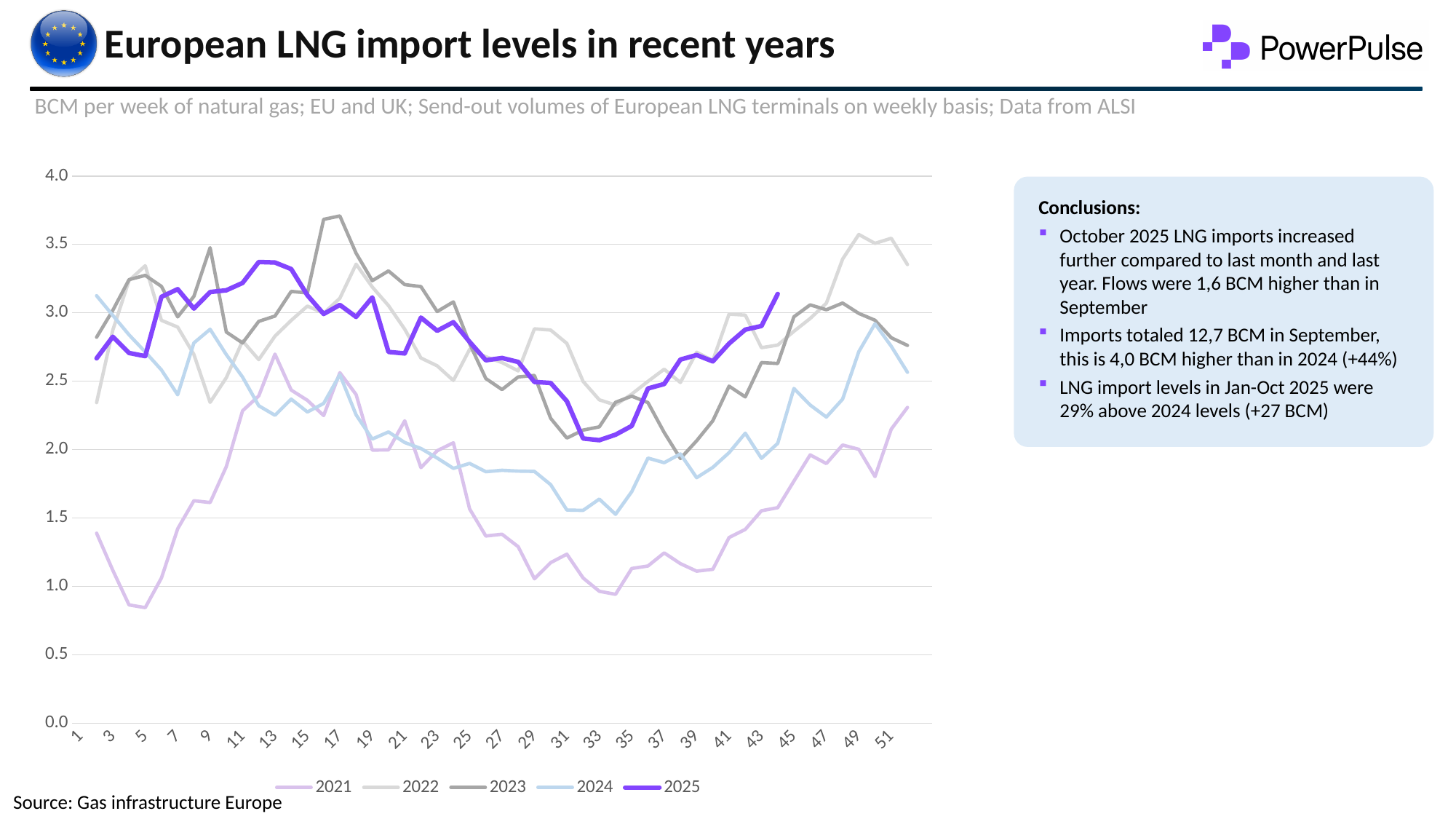
Is the value for 2024 at week 31 greater or less than 2.0? less Which years are listed in the chart legend? 2021, 2022, 2023, 2024, 2025 How many series does the legend list? 5 Which series has the lowest value at week 5? 2021 Is the value for 2021 at week 5 greater or less than 1.0? less Which series is drawn as the thick purple line? 2025 At week 17, which series has the larger value, 2023 or 2021? 2023 What kind of chart is shown on the slide? Line chart Is the value for 2025 at week 13 greater or less than 3.0? greater Does the 2021 series rise or fall from week 33 to week 51? Rise At week 33, which series has the larger value, 2021 or 2024? 2024